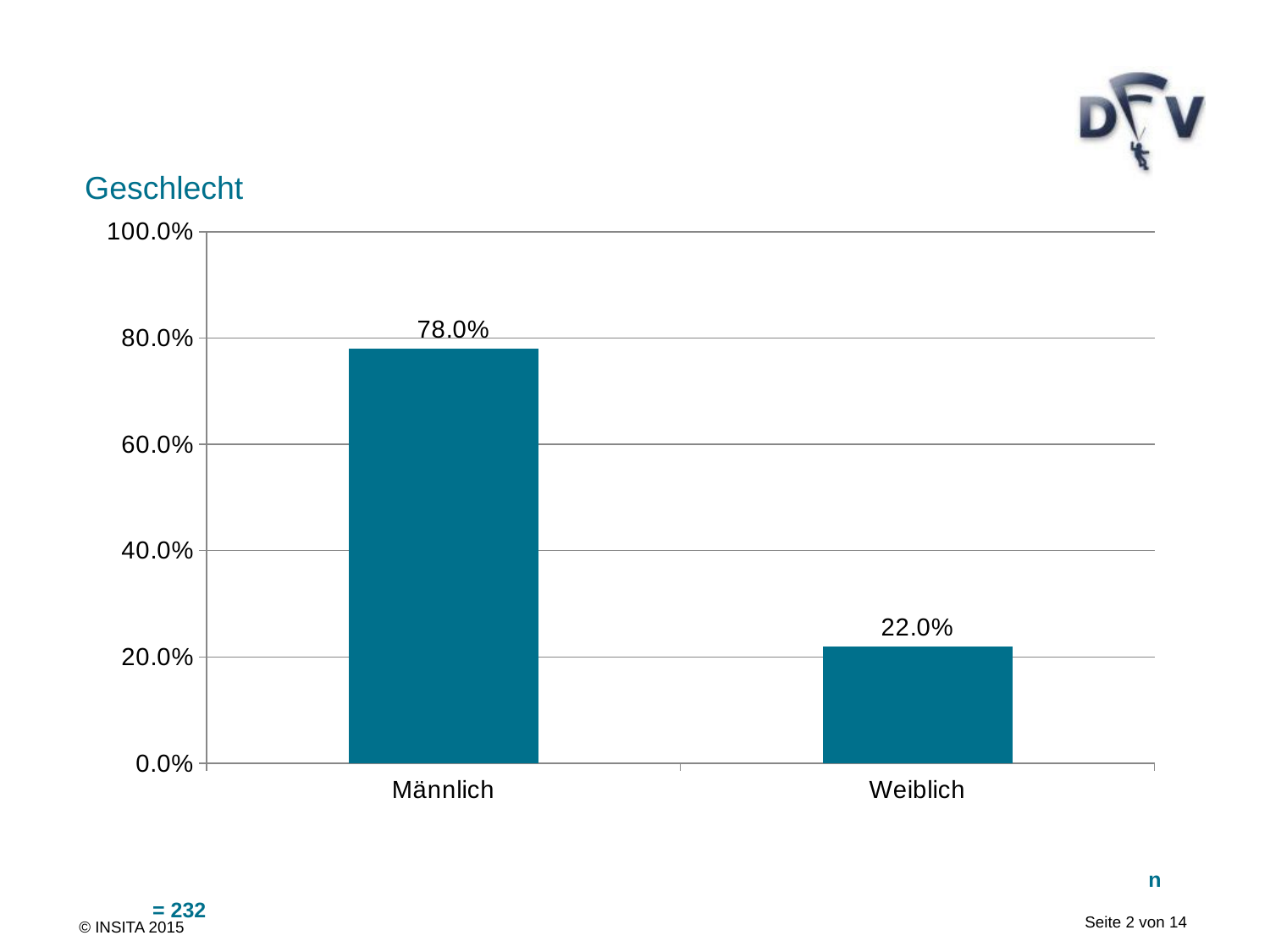
Is the value for Männlich greater or less than 60.0%? greater Which category has the highest value? Männlich Which category has the lowest value? Weiblich What is the value for Weiblich? 22.0% What kind of chart is shown on the slide? bar chart What is the highest value shown on the y axis? 100.0% What is the value for Männlich? 78.0% How many categories are shown on the x axis? 2 Is the value for Weiblich greater or less than 40.0%? less What is the title of the chart? Geschlecht Which is larger, the value for Männlich or the value for Weiblich? Männlich What is the difference between the values for Männlich and Weiblich? 56.0%